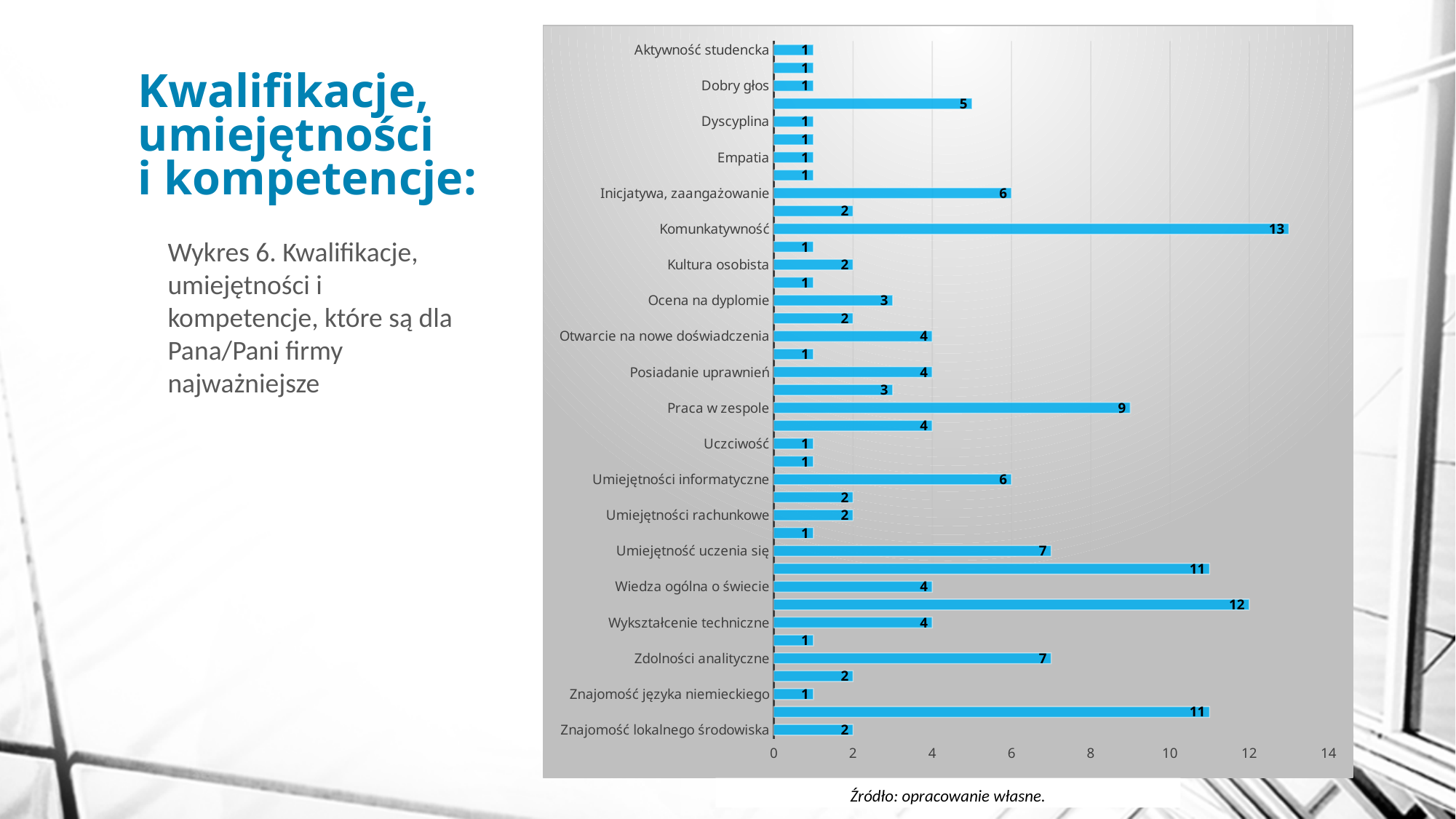
What is the source given below the chart? Źródło: opracowanie własne. Which is larger, the value for Zdolności analityczne or the value for Wiedza ogólna o świecie? Zdolności analityczne What is the value for Ocena na dyplomie? 3 What is the difference between the values for Komunkatywność and Praca w zespole? 4 What is the value for Komunkatywność? 13 What is the value for Inicjatywa, zaangażowanie? 6 What is the value for Praca w zespole? 9 What is the maximum value shown on the horizontal axis? 14 What kind of chart is shown on the slide? bar chart Is the value for Praca w zespole greater or less than 8? greater What is the value for Umiejętność uczenia się? 7 Which labelled category has the highest value? Komunkatywność